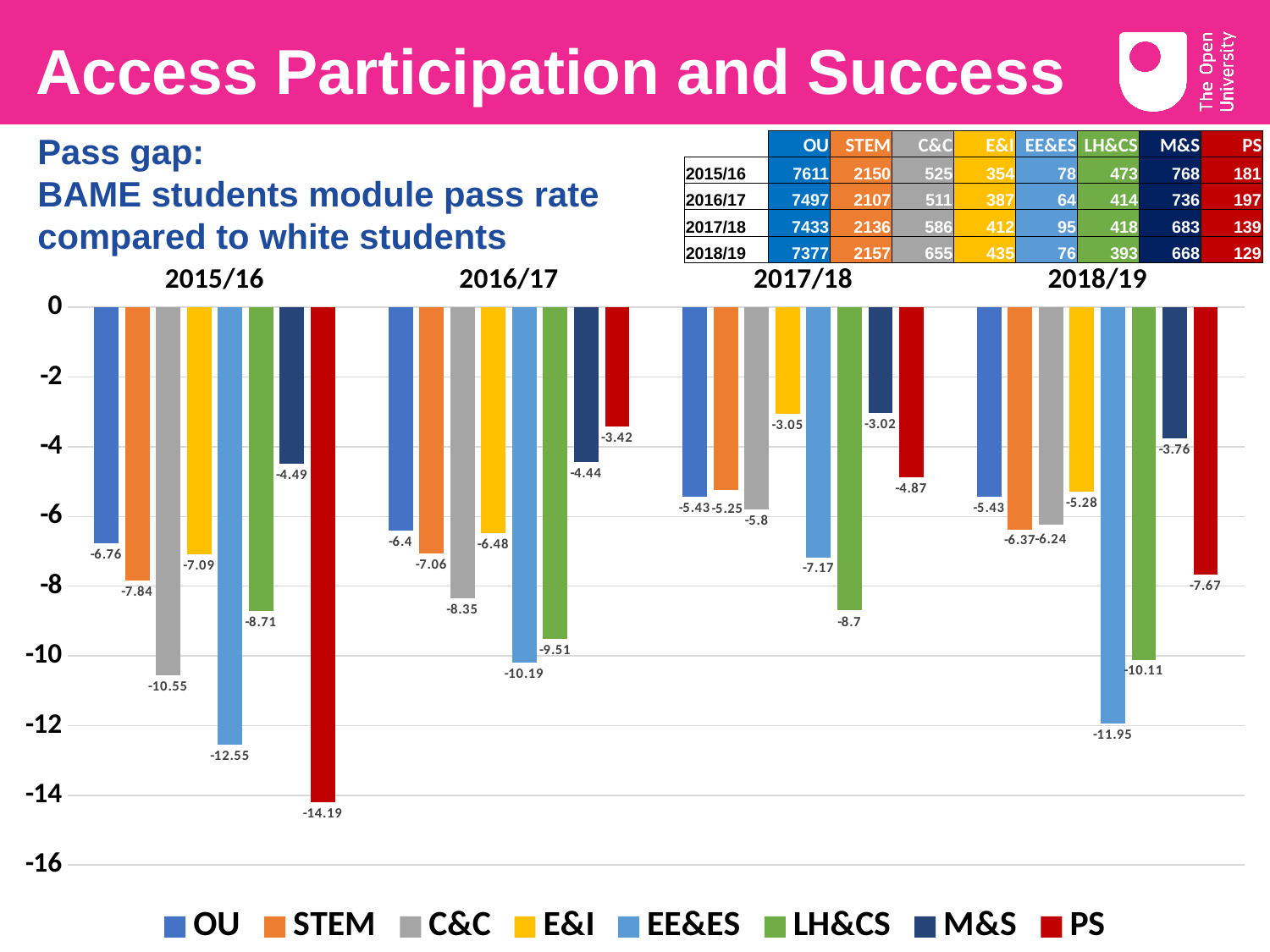
What is the value for OU in 2016/17? -6.4 Which is more negative: EE&ES in 2016/17 or LH&CS in 2016/17? EE&ES in 2016/17 Which series has the lowest (most negative) value in 2018/19? EE&ES Which series has the lowest (most negative) value in 2015/16? PS Which series has the highest (closest to zero) value in 2015/16? M&S What kind of chart is shown on the slide? Bar chart What is the value for EE&ES in 2018/19? -11.95 How many series does the legend list? 8 What is the value for M&S in 2017/18? -3.02 How many year categories are shown on the x axis? 4 What is the difference between the PS value and the M&S value in 2015/16? 9.7 What is the value for PS in 2015/16? -14.19